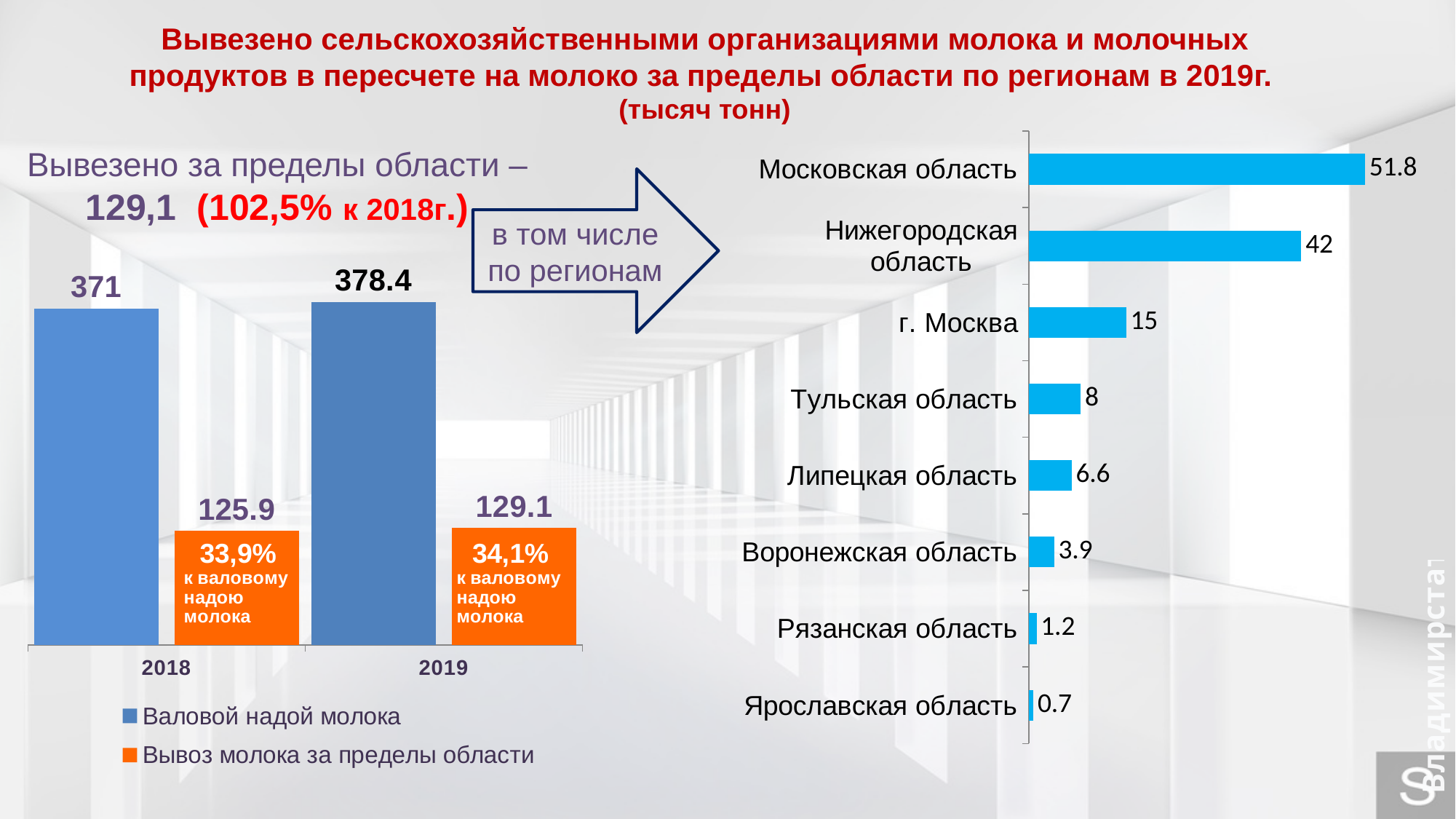
In the right chart (by region), what is the value for Липецкая область? 6.6 In the left chart, what is the value of Вывоз молока за пределы области for 2018? 125.9 What type of chart is the right chart (by region)? bar chart In the right chart (by region), which region has the lowest value? Ярославская область In the right chart (by region), what is the value for Нижегородская область? 42 In the right chart (by region), which region has the highest value? Московская область In the left chart, does Вывоз молока за пределы области rise or fall from 2018 to 2019? rise In the left chart, by how much did Валовой надой молока change from 2018 to 2019? 7.4 In the left chart, what is the value of Валовой надой молока for 2019? 378.4 In the right chart (by region), how many regions are shown? 8 In the right chart (by region), what is the difference between Московская область and г. Москва? 36.8 In the left chart, how many series does the legend list? 2